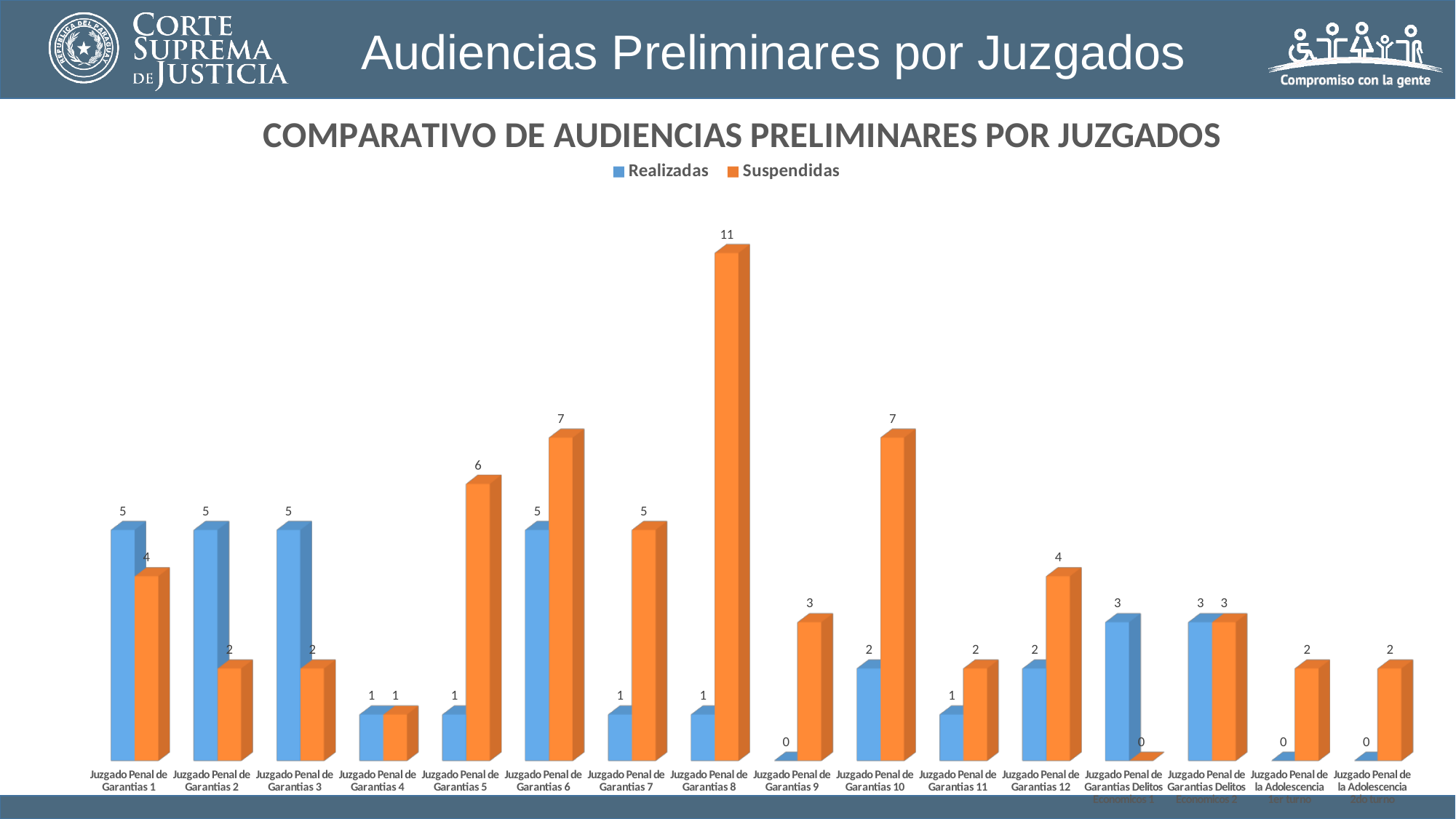
How many juzgados (categories) are shown on the x axis? 16 Which juzgado has the highest Suspendidas value? Juzgado Penal de Garantias 8 What colour represents the Suspendidas series? orange What is the total of Realizadas and Suspendidas for Juzgado Penal de Garantias 6? 12 What is the Realizadas value for Juzgado Penal de Garantias 9? 0 What is the Realizadas value for Juzgado Penal de Garantias 10? 2 What type of chart is shown on the slide? bar chart For Juzgado Penal de Garantias 1, which is larger, Realizadas or Suspendidas? Realizadas What is the Suspendidas value for Juzgado Penal de Garantias 5? 6 How many series does the legend list? 2 What is the Suspendidas value for Juzgado Penal de Garantias 8? 11 What is the difference between Suspendidas and Realizadas for Juzgado Penal de Garantias 8? 10